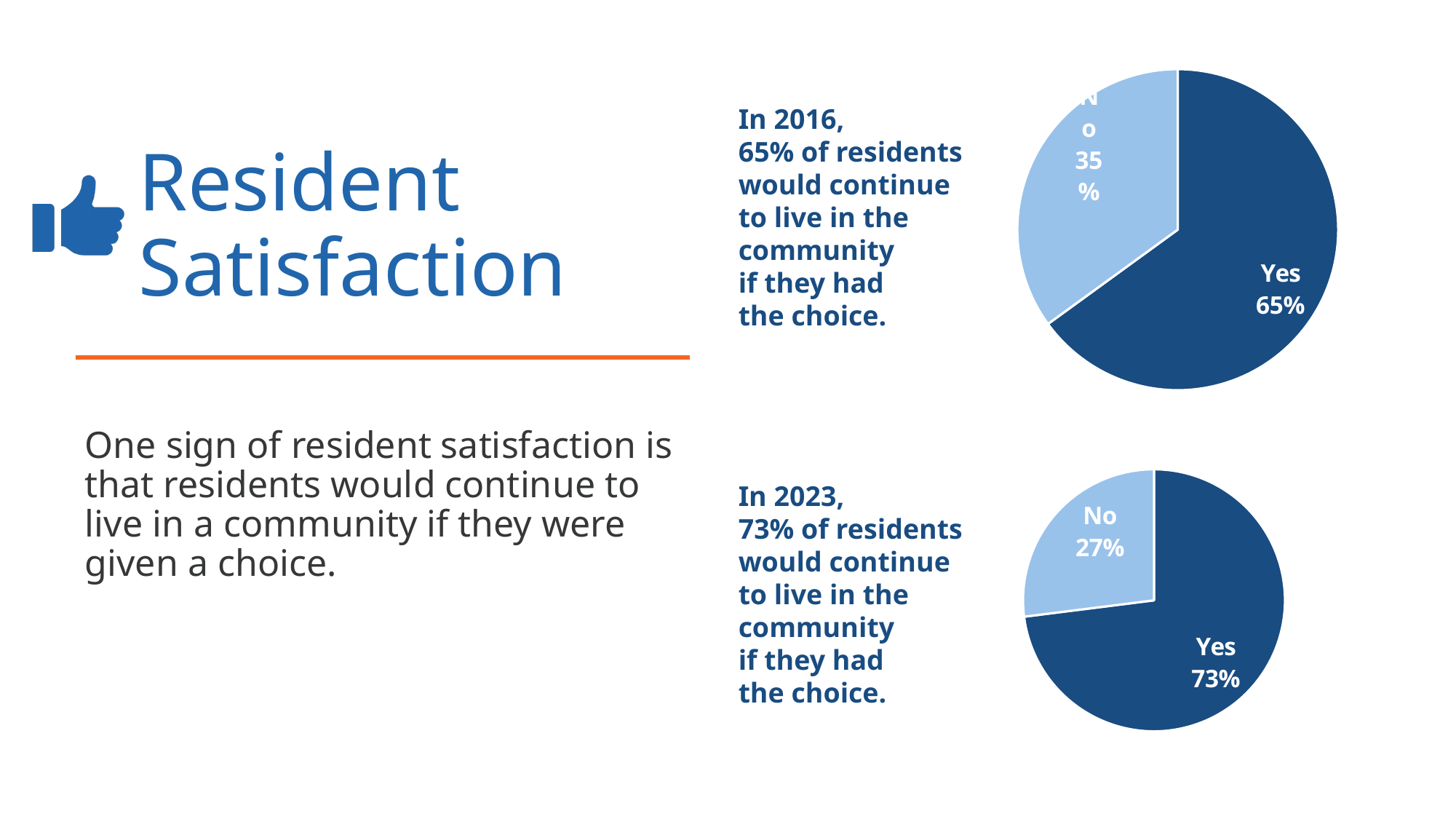
In the 2023 pie chart, which slice is the smallest? No Is the Yes share larger in the 2016 pie chart or the 2023 pie chart? 2023 How many pie charts are shown on the slide? 2 In the 2023 pie chart, what is the difference between the Yes and No shares? 46% In the 2016 pie chart, what is the difference between the Yes and No shares? 30% In the 2023 pie chart, what percentage of residents answered No? 27% In the 2016 pie chart, which slice is the largest? Yes How many slices does the 2023 pie chart have? 2 In the 2016 pie chart, what percentage of residents answered No? 35% In the 2016 pie chart, what percentage of residents answered Yes? 65% In the 2023 pie chart, what percentage of residents answered Yes? 73% What kind of chart is used to show the 2016 results? Pie chart